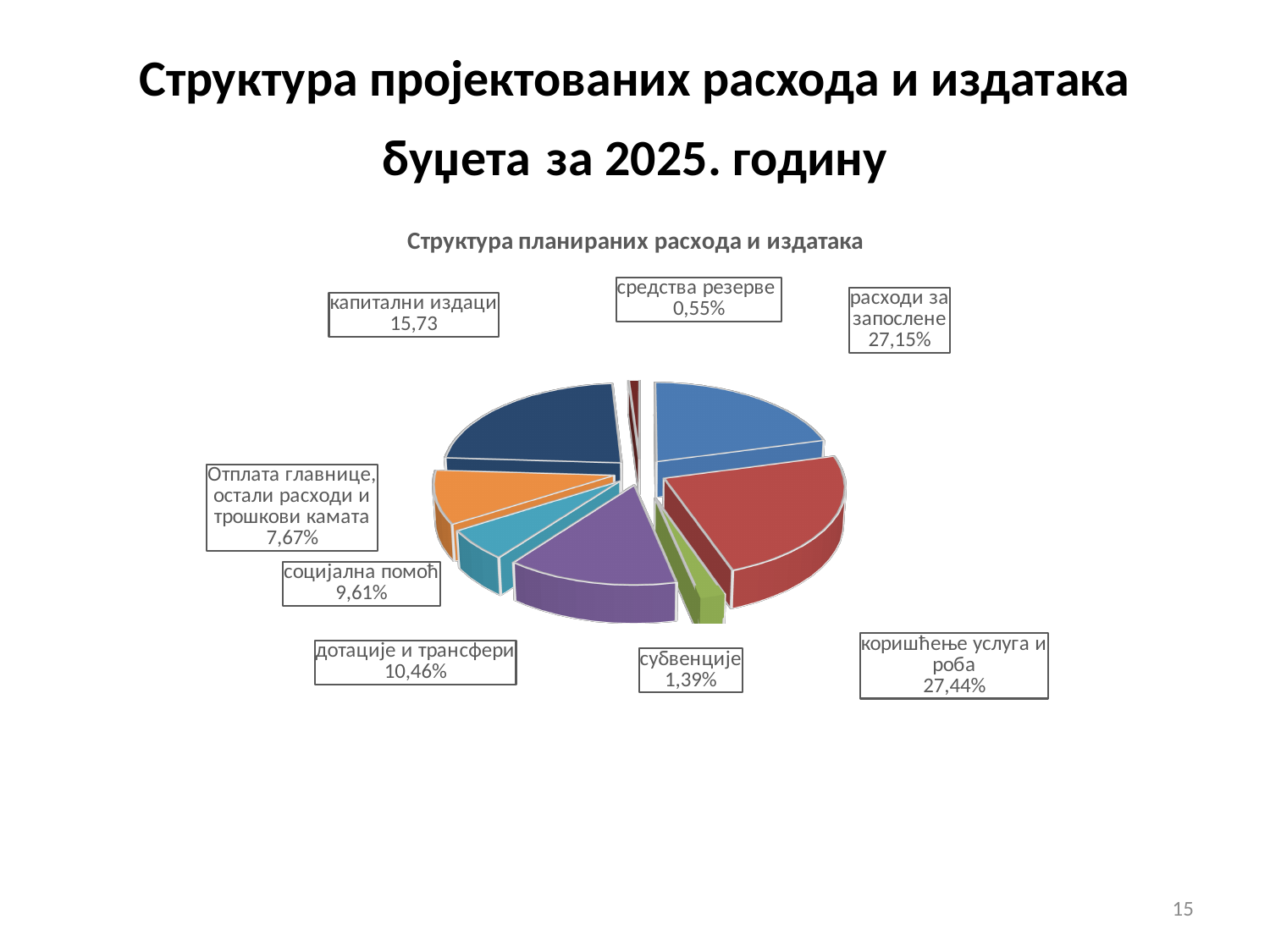
What share of the pie does 'расходи за запослене' represent? 27,15% How many slices does the pie chart have? 8 Which category has the smallest share of the pie? средства резерве Which is larger: 'дотације и трансфери' or 'социјална помоћ'? дотације и трансфери What is the difference in percentage points between 'коришћење услуга и роба' and 'расходи за запослене'? 0,29 What value is shown for 'субвенције'? 1,39% Which category has the largest share of the pie? коришћење услуга и роба What value is labelled for 'капитални издаци'? 15,73 What value is shown for 'коришћење услуга и роба'? 27,44% What share is shown for 'социјална помоћ'? 9,61% What type of chart is shown on the slide? Pie chart What is the title of the chart? Структура планираних расхода и издатака